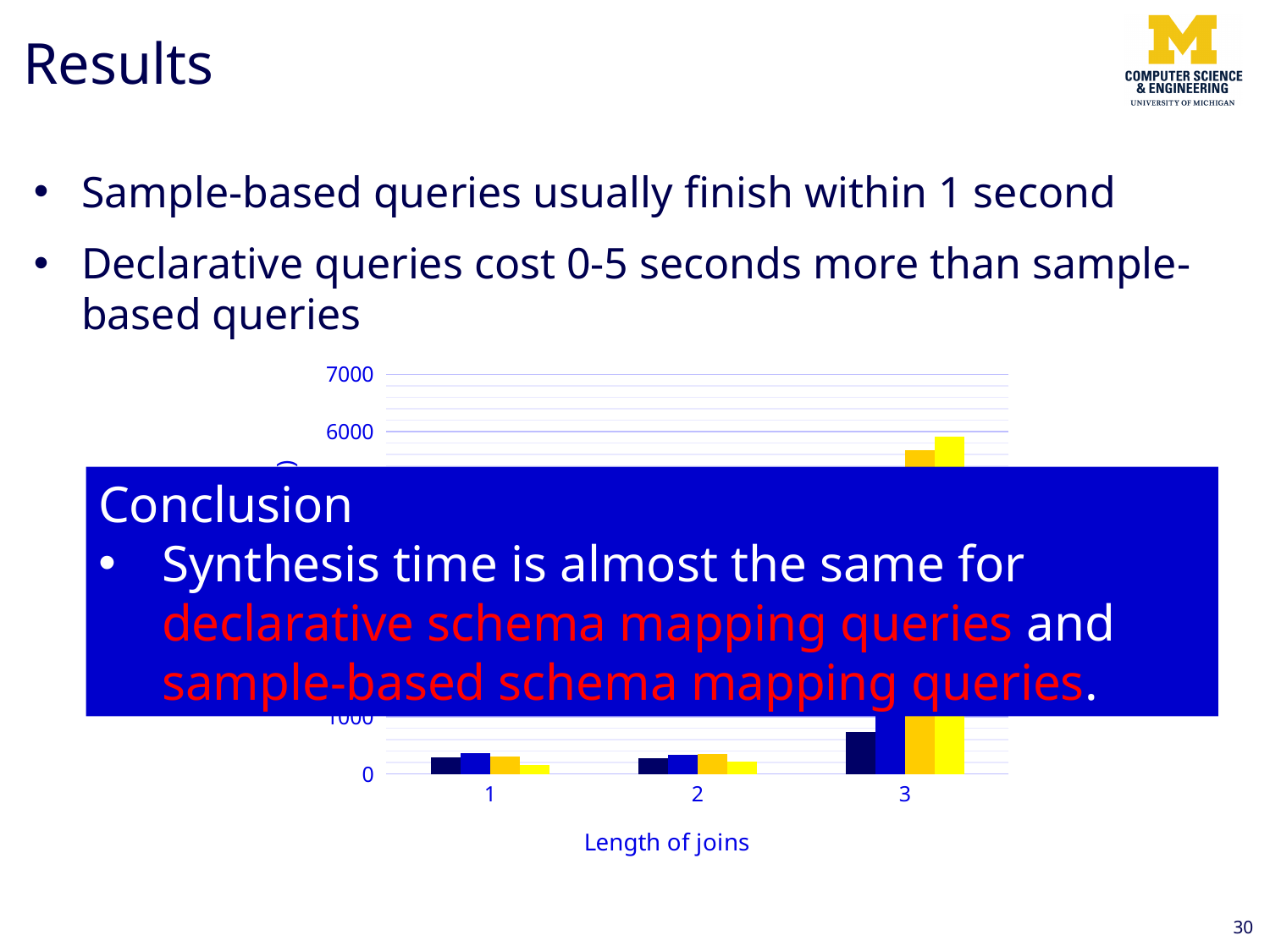
Do the bar heights generally rise or fall as the length of joins increases from 1 to 3? rise For length of joins 3, which is larger: the yellow bar or the orange bar? the yellow bar Which length of joins has the tallest bars in the chart? 3 Are the bars for length of joins 2 greater or less than 1000? less Are the bars for length of joins 1 greater or less than 1000? less Is the value of the orange bar for length of joins 3 greater or less than 1000? greater How many bars are plotted for each length of joins? 4 What is the title of the x axis of the chart? Length of joins What kind of chart is shown on the slide? bar chart What is the highest value labelled on the y axis of the chart? 7000 How many categories are shown on the x axis of the chart? 3